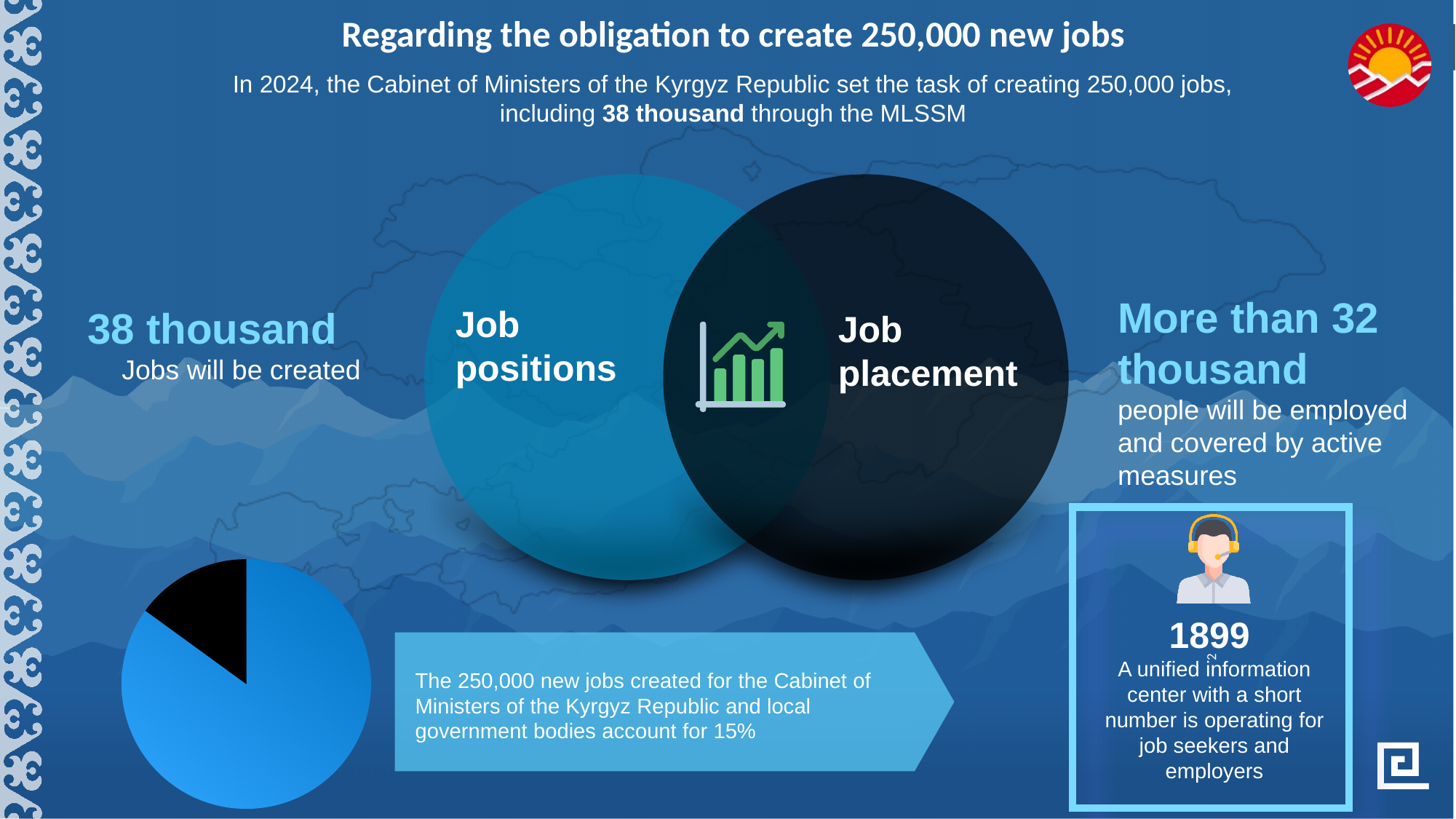
What kind of chart is shown at the bottom left of the slide? pie chart In the pie chart at the bottom left, which colour slice is the largest? blue In the pie chart at the bottom left, which slice is larger, the blue one or the black one? the blue one How many slices does the pie chart at the bottom left have? 2 Is the black slice of the pie chart at the bottom left greater or less than 50% of the pie? less Does the pie chart at the bottom left have a legend? No In the pie chart at the bottom left, which colour slice is the smallest? black What two colours are used for the slices of the pie chart at the bottom left? blue and black According to the text next to the pie chart, what share of the 250,000 new jobs is accounted for by the Cabinet of Ministers and local government bodies? 15%